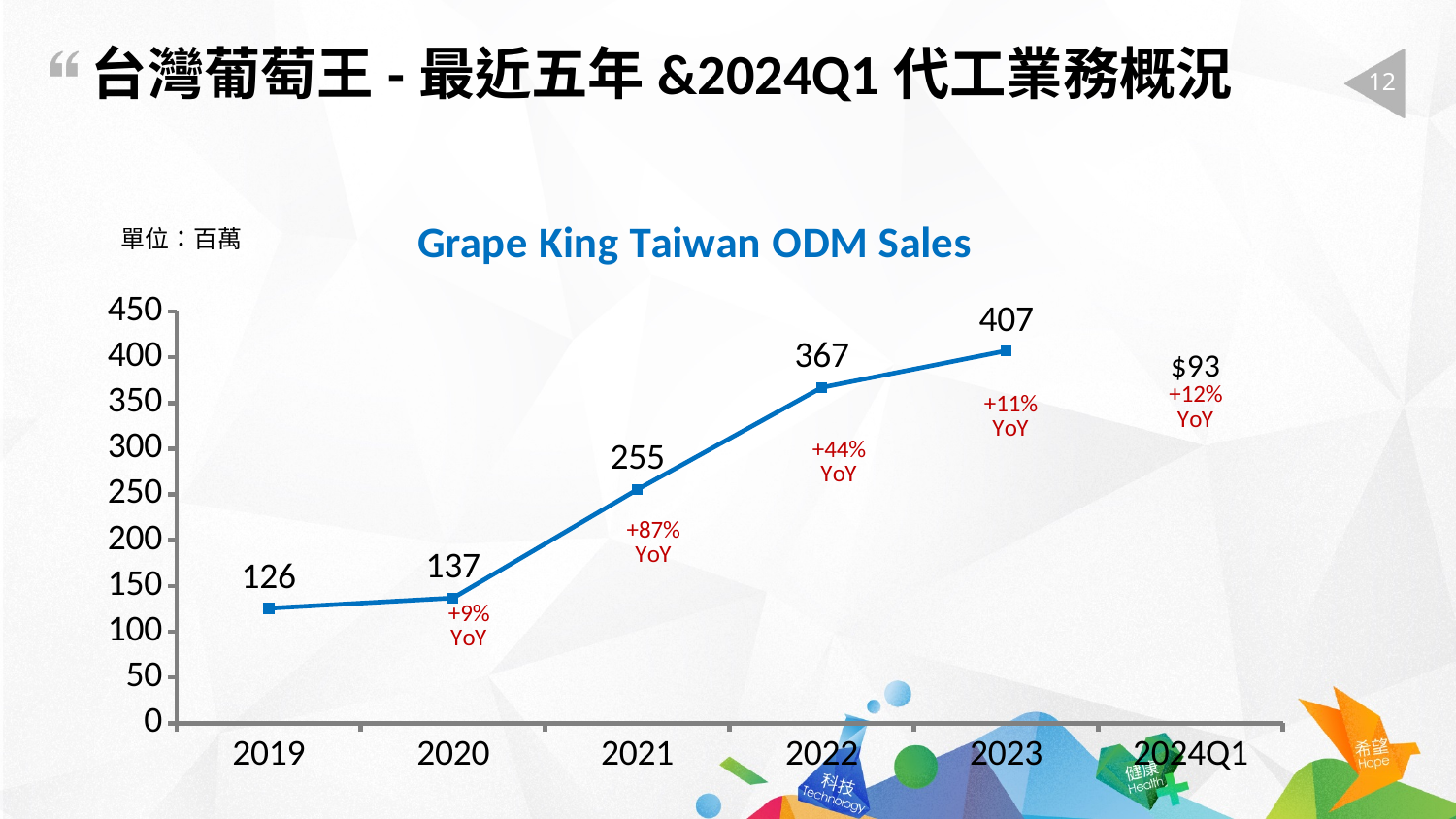
What is the title of the chart? Grape King Taiwan ODM Sales Which year has the lowest ODM sales value on the line? 2019 What value is shown for 2024Q1? $93 What is the ODM sales value for 2023? 407 What type of chart is shown on the slide? line chart What is the difference between the 2023 value and the 2022 value? 40 What YoY growth percentage is shown for 2021? +87% What is the ODM sales value for 2021? 255 What is the ODM sales value for 2019? 126 Which is larger, the value for 2021 or the value for 2020? 2021 Do the values rise or fall from 2019 to 2023? rise Which year has the highest ODM sales value on the line? 2023